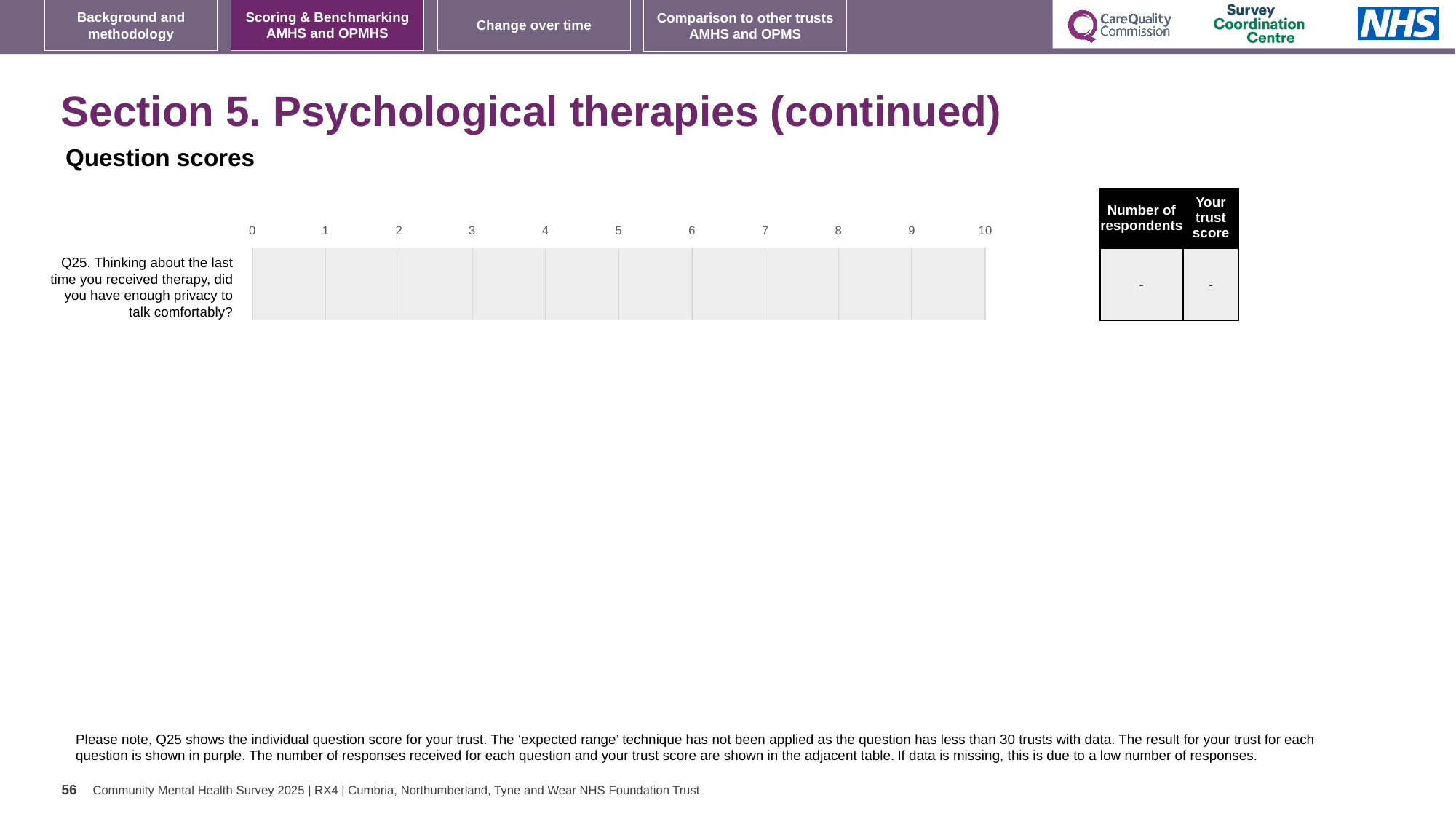
Is a bar plotted for Q25 on the chart? No What is the highest value shown on the chart's horizontal axis? 10 What is the lowest value shown on the chart's horizontal axis? 0 Which question number is shown on the chart? Q25 What is shown in the 'Number of respondents' column for Q25 in the adjacent table? - How many questions (categories) are listed on the chart's vertical axis? 1 What is shown in the 'Your trust score' column for Q25 in the adjacent table? -